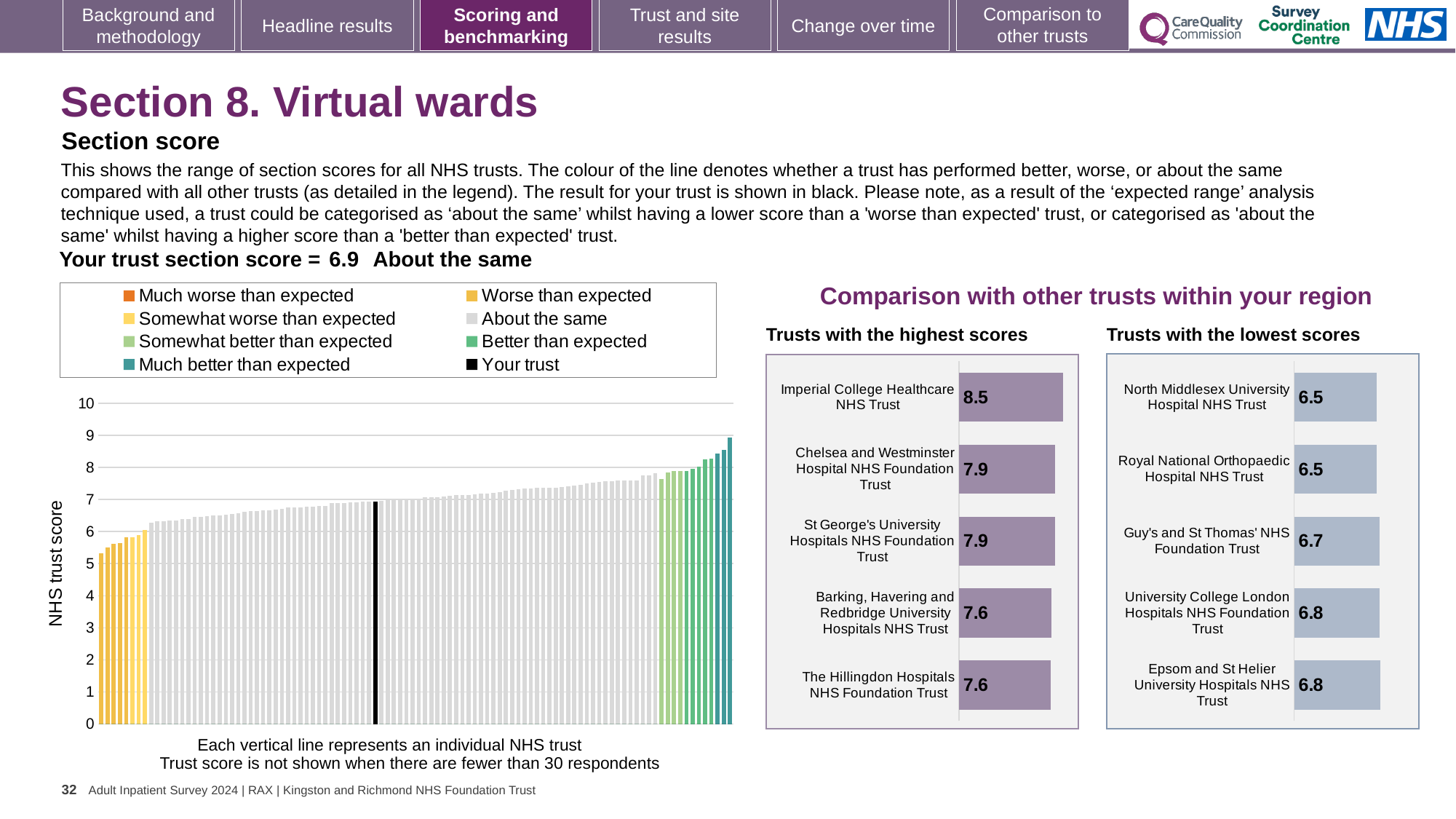
In the 'Trusts with the highest scores' chart, how many trusts are listed? 5 In the 'Trusts with the lowest scores' chart, which is larger: the score for Guy's and St Thomas' NHS Foundation Trust or the score for North Middlesex University Hospital NHS Trust? Guy's and St Thomas' NHS Foundation Trust In the 'Trusts with the highest scores' chart, what is the difference between the scores of Imperial College Healthcare NHS Trust and The Hillingdon Hospitals NHS Foundation Trust? 0.9 In the 'Trusts with the highest scores' chart, which trust has the highest score? Imperial College Healthcare NHS Trust In the 'Trusts with the lowest scores' chart, what is the score for Guy's and St Thomas' NHS Foundation Trust? 6.7 In the 'Trusts with the lowest scores' chart, what is the difference between the scores of University College London Hospitals NHS Foundation Trust and Royal National Orthopaedic Hospital NHS Trust? 0.3 In the main NHS trust score chart on the left, what is the section score for your trust? 6.9 In the main NHS trust score chart on the left, do the trust scores rise or fall from left to right? rise In the main NHS trust score chart on the left, how many entries does the legend list? 8 In the main NHS trust score chart on the left, is the value of the tallest bar greater or less than 8? greater In the 'Trusts with the highest scores' chart, what is the score for Imperial College Healthcare NHS Trust? 8.5 In the 'Trusts with the lowest scores' chart, what is the score for Epsom and St Helier University Hospitals NHS Trust? 6.8